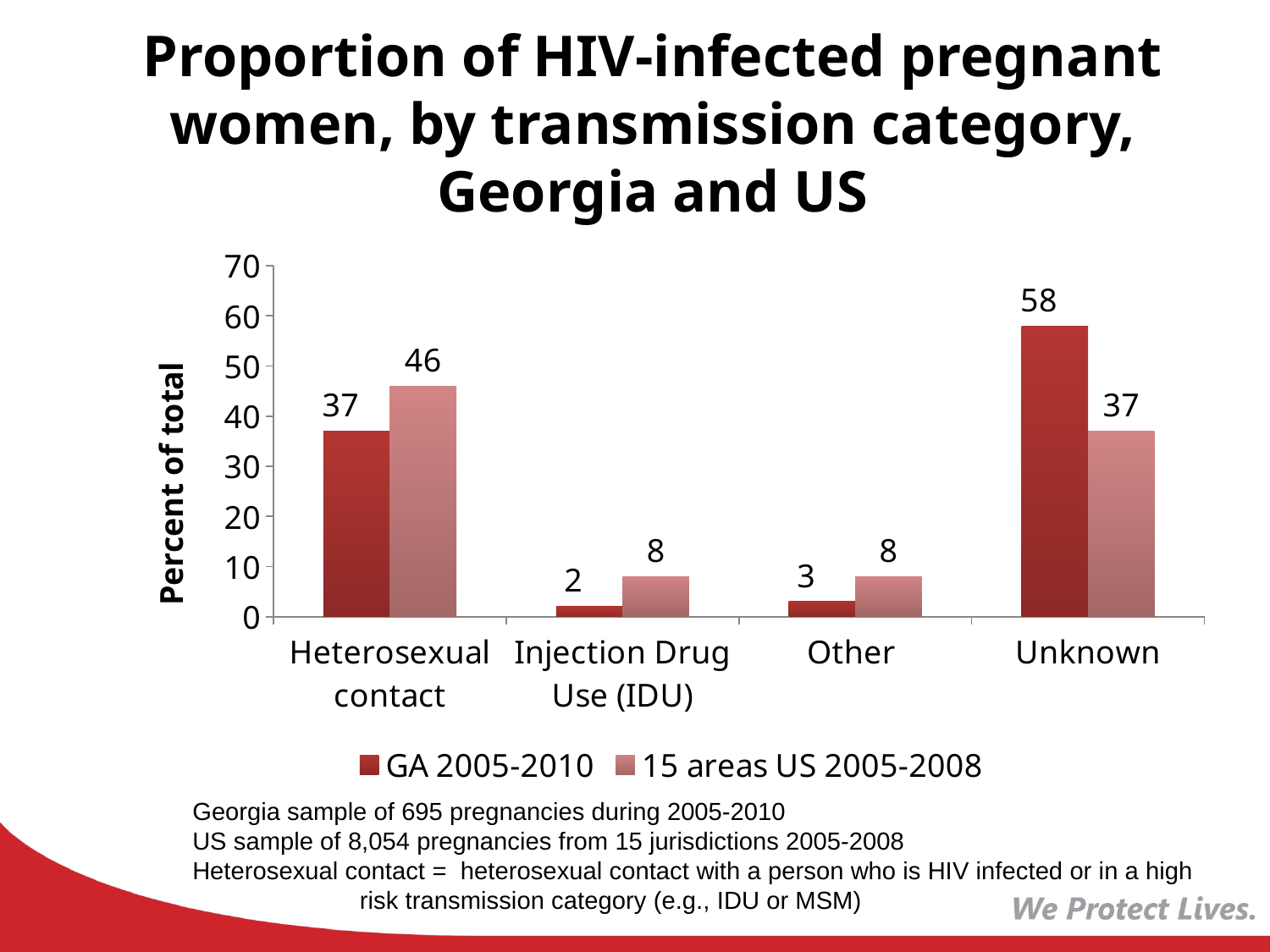
How many transmission categories are shown on the x axis? 4 Which category has the lowest value in the 15 areas US 2005-2008 series? Injection Drug Use (IDU) and Other (both 8) Is the GA 2005-2010 value for Unknown greater or less than 50? greater What is the value for Heterosexual contact in the GA 2005-2010 series? 37 What is the difference between the GA 2005-2010 and 15 areas US 2005-2008 values for Unknown? 21 How many series does the legend list? 2 Which category has the highest value in the GA 2005-2010 series? Unknown What kind of chart is shown on the slide? Bar chart For Heterosexual contact, which series has the larger value, GA 2005-2010 or 15 areas US 2005-2008? 15 areas US 2005-2008 What is the label of the y axis? Percent of total What is the value for Unknown in the 15 areas US 2005-2008 series? 37 What is the value for Injection Drug Use (IDU) in the GA 2005-2010 series? 2